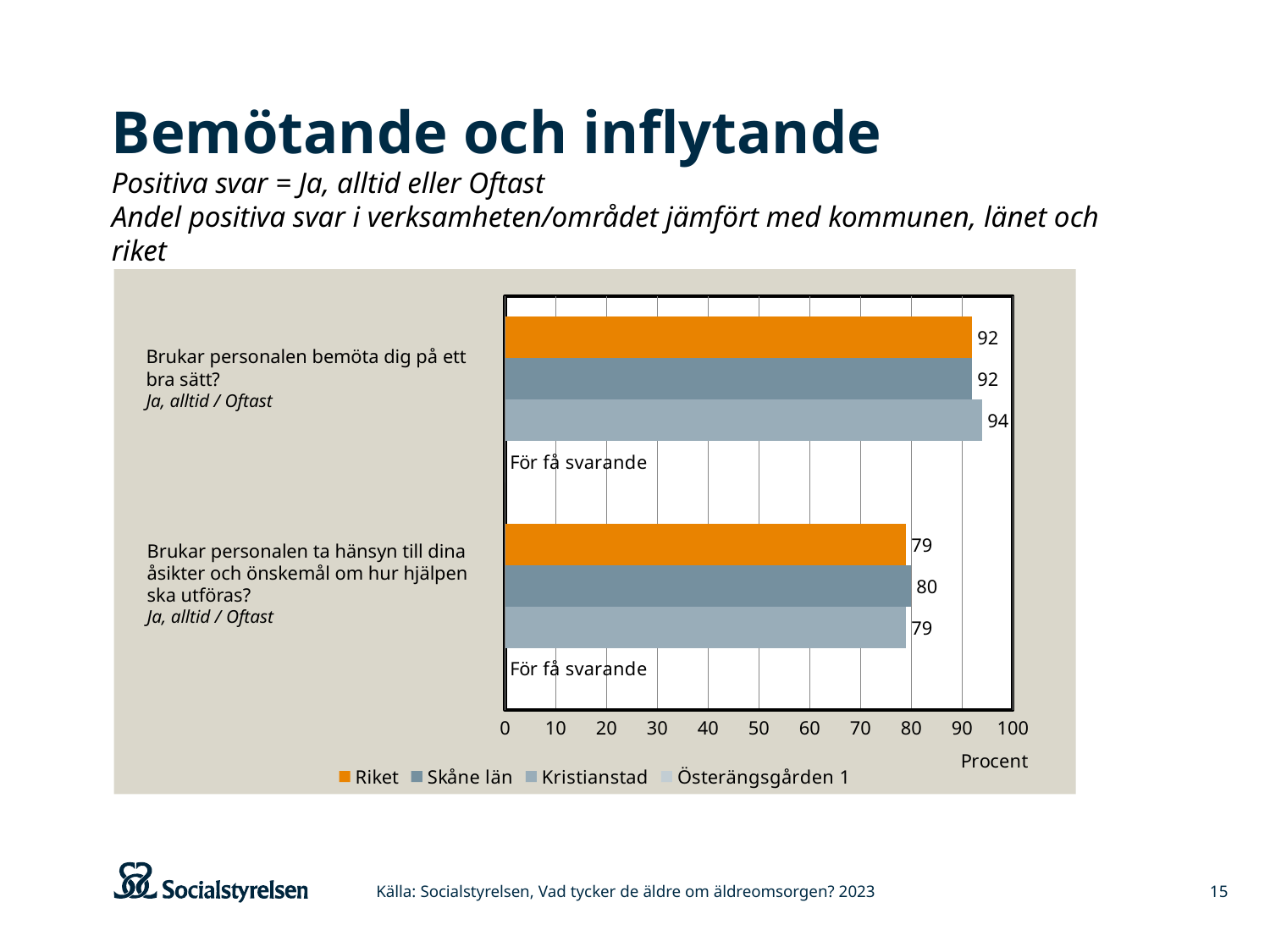
What is the value for Kristianstad on the question "Brukar personalen bemöta dig på ett bra sätt?"? 94 How many question categories are shown on the chart? 2 What unit is labelled on the x axis? Procent What is the difference between the Kristianstad values for the two questions? 15 What is the difference between the Kristianstad value and the Riket value on the question "Brukar personalen bemöta dig på ett bra sätt?"? 2 Which series has the highest value on the question "Brukar personalen bemöta dig på ett bra sätt?"? Kristianstad What is shown for Österängsgården 1 instead of a bar? För få svarande What is the value for Riket on the question "Brukar personalen ta hänsyn till dina åsikter och önskemål om hur hjälpen ska utföras?"? 79 What is the value for Skåne län on the question "Brukar personalen ta hänsyn till dina åsikter och önskemål om hur hjälpen ska utföras?"? 80 What kind of chart is shown on the slide? Bar chart How many series does the legend list? 4 What is the value for Riket on the question "Brukar personalen bemöta dig på ett bra sätt?"? 92